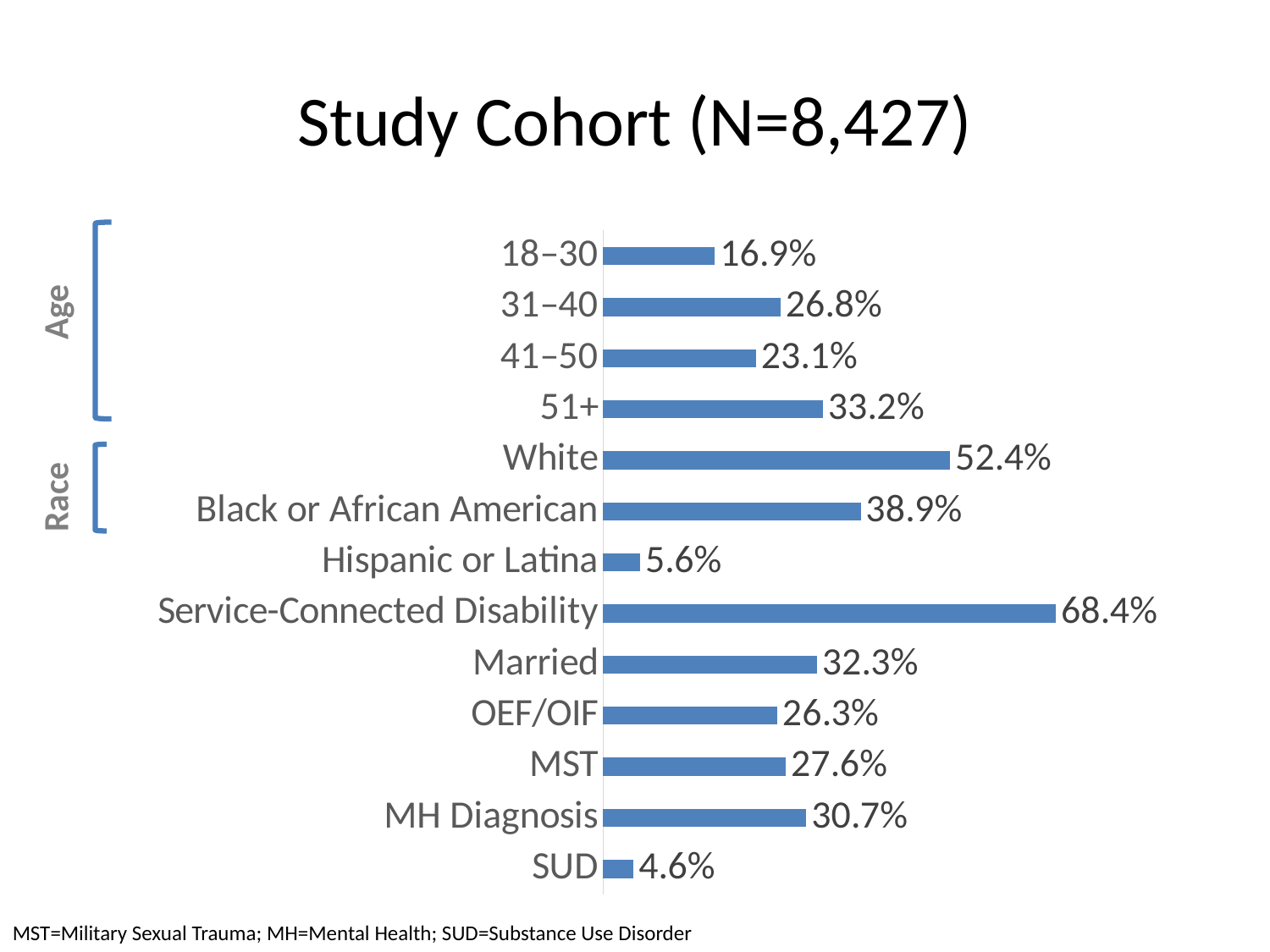
What percentage of the study cohort is aged 51+? 33.2% What is the difference in percentage points between White and Black or African American? 13.5 What percentage of the study cohort is Black or African American? 38.9% Which is larger, the percentage for MST or the percentage for OEF/OIF? MST What percentage of the study cohort has an MH Diagnosis? 30.7% What type of chart is shown on the slide? Bar chart How many categories are shown in the chart? 13 What is the title of the slide? Study Cohort (N=8,427) Which category has the lowest percentage in the chart? SUD Which category has the highest percentage in the chart? Service-Connected Disability What is the difference in percentage points between the 51+ and 18–30 age groups? 16.3 What percentage of the study cohort has a Service-Connected Disability? 68.4%